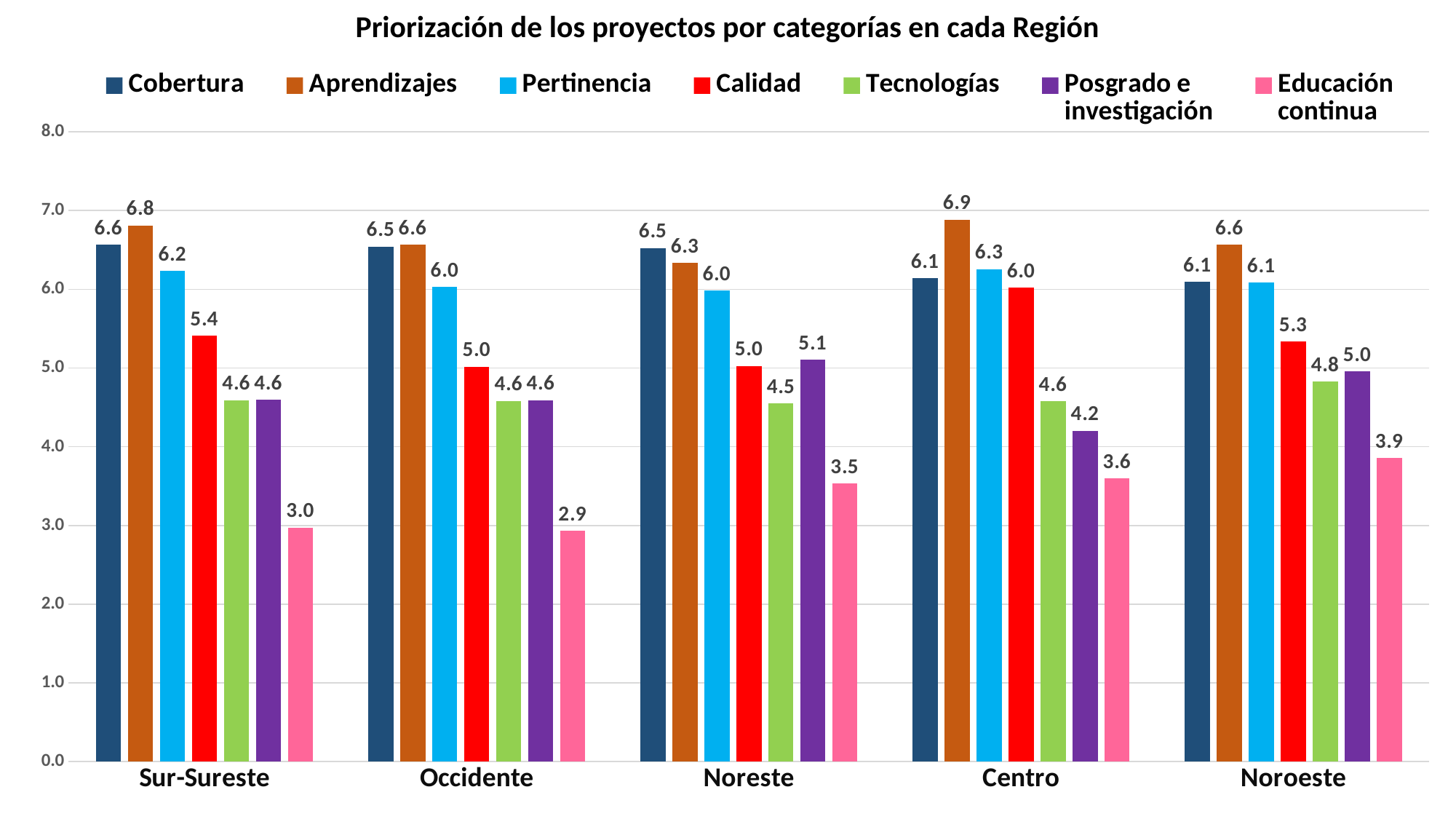
In the Noreste region, which category has the highest value? Cobertura Which is larger: Posgrado e investigación in Noreste or in Centro? Noreste What is the value for Calidad in the Noroeste region? 5.3 Is the value for Tecnologías in Noroeste greater or less than 4.0? greater What is the difference between Cobertura and Educación continua in the Sur-Sureste region? 3.6 How many series does the legend list? 7 How many regions are shown on the x axis? 5 Which region has the highest value for Aprendizajes? Centro What is the value for Educación continua in the Occidente region? 2.9 What is the value for Aprendizajes in the Centro region? 6.9 What kind of chart is shown on the slide? Bar chart Which region has the lowest value for Educación continua? Occidente